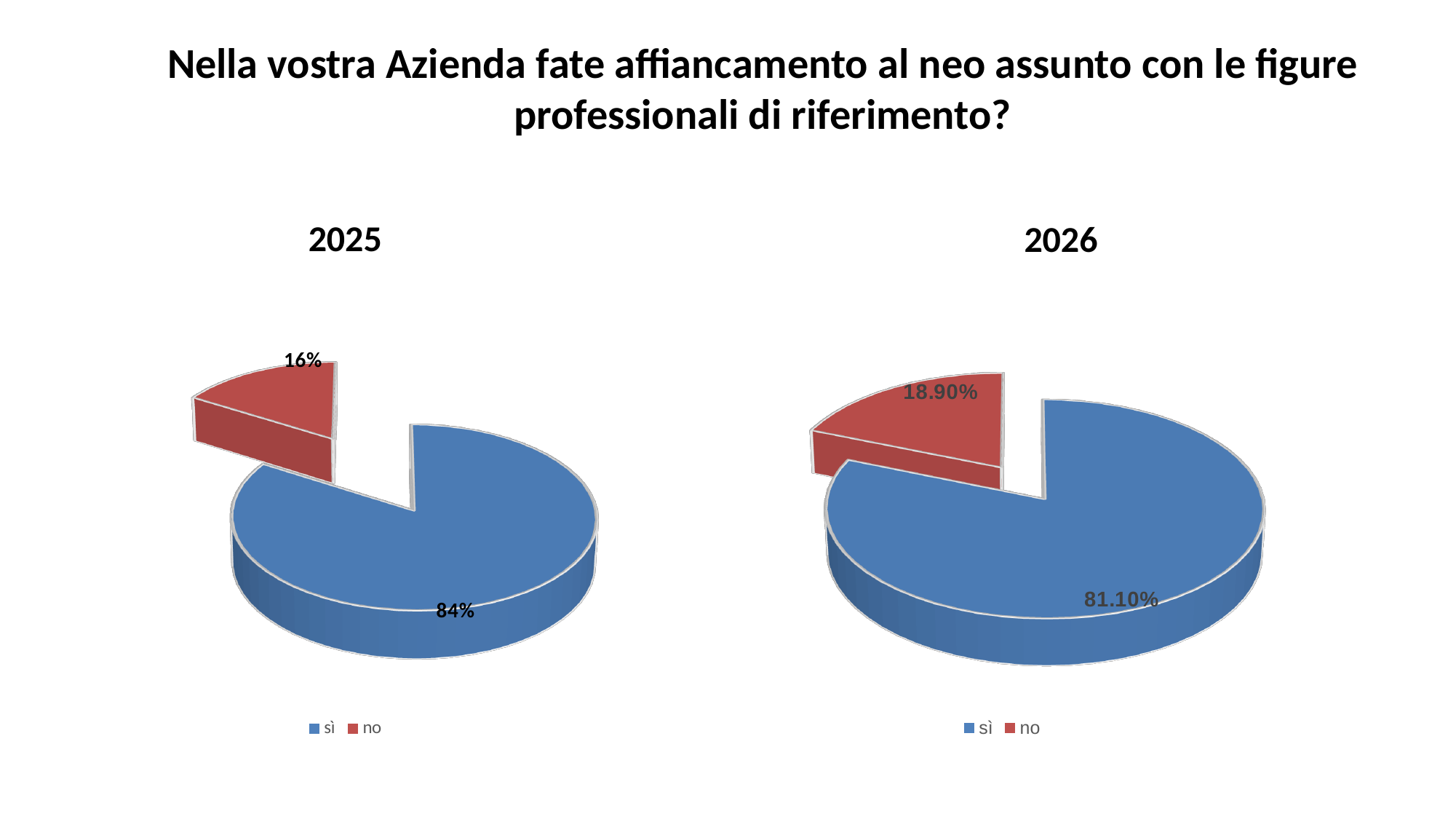
In the 2025 pie chart, what share is labelled for 'no'? 16% In the 2025 pie chart, which category has the largest slice? sì What kind of chart is the 2025 chart? Pie chart Is the 'no' share larger in the 2025 chart or the 2026 chart? 2026 In the 2026 pie chart, what colour is the 'no' slice? Red In the 2025 pie chart, what is the difference between the 'sì' and 'no' shares? 68% In the 2026 pie chart, what share is labelled for 'no'? 18.90% In the 2026 pie chart, what share is labelled for 'sì'? 81.10% In the 2025 pie chart, what share is labelled for 'sì'? 84% In the 2026 pie chart, which category has the smallest slice? no How many entries does the legend of the 2025 chart list? 2 How many slices does the 2026 pie chart have? 2